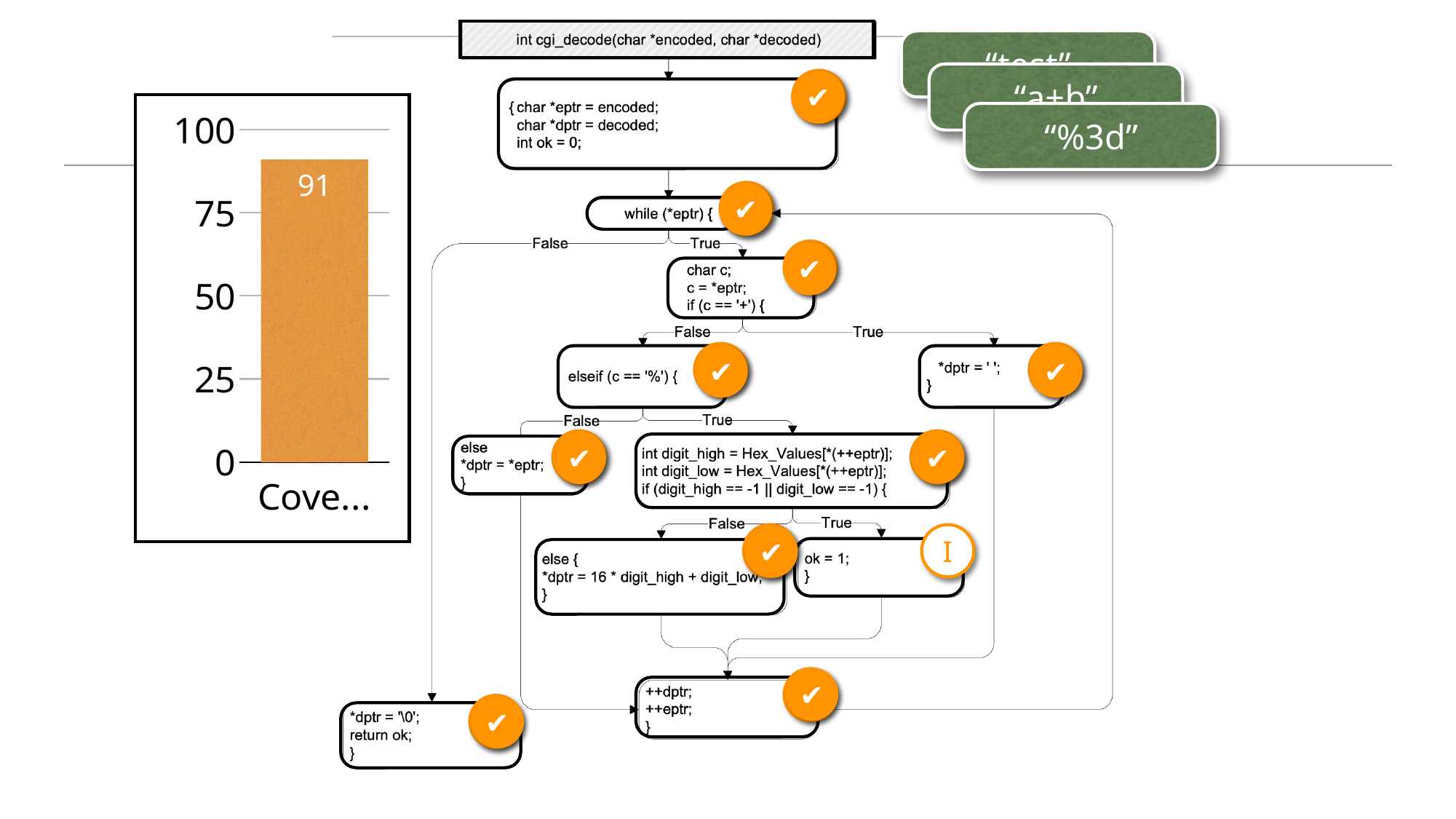
Is the value of the bar in the chart greater or less than 75? greater How many bars does the chart on the left of the slide contain? 1 What is the highest tick value shown on the vertical axis of the chart? 100 What value is shown on the bar in the chart on the left of the slide? 91 What is the lowest tick value shown on the vertical axis of the chart? 0 What kind of chart is shown on the left of the slide? bar chart Is the value of the bar in the chart greater or less than 50? greater Is the value of the bar in the chart greater or less than 100? less